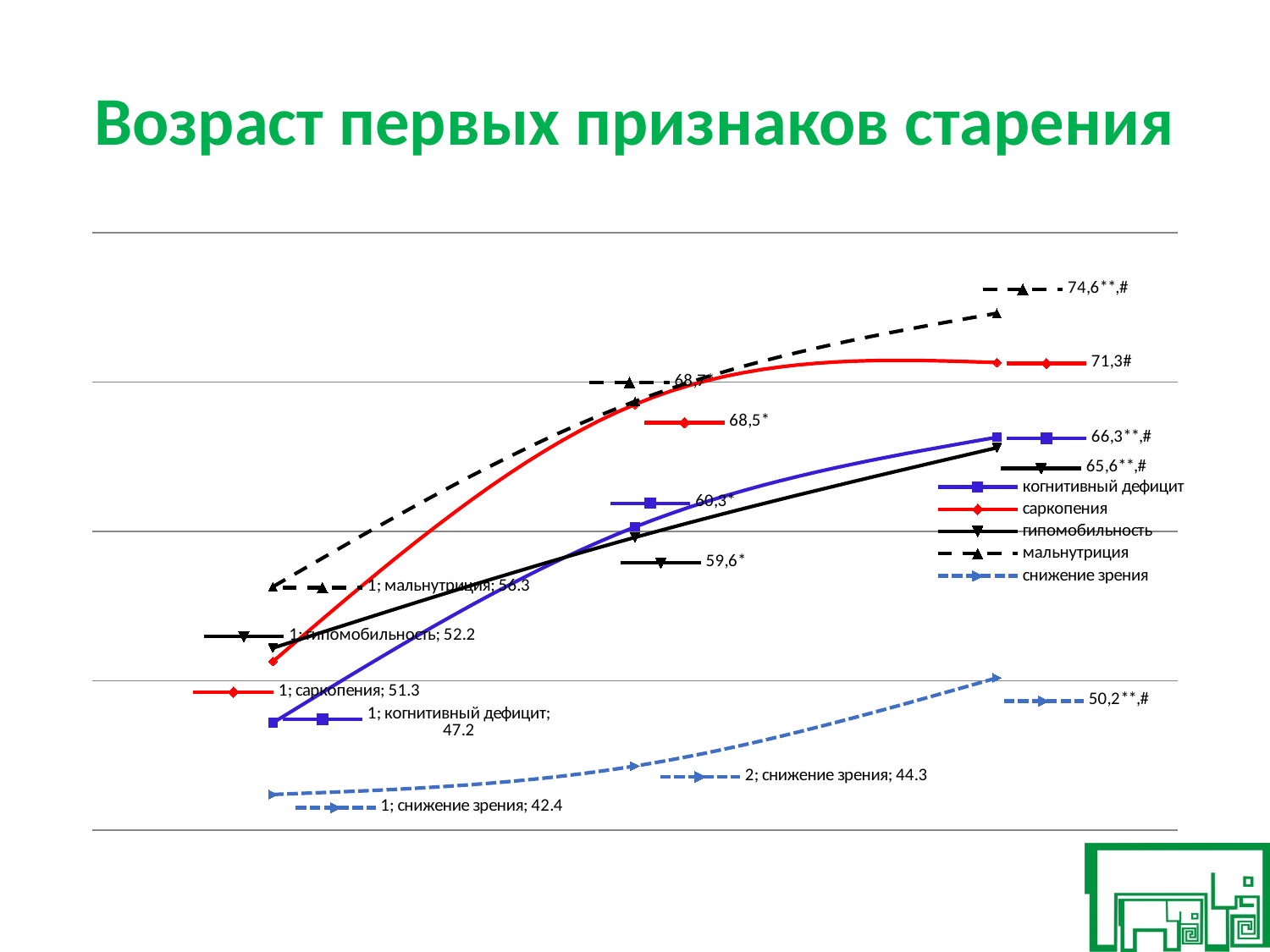
What is the value labelled for саркопения at point 1? 51.3 Which is larger at point 1: the value for мальнутриция or the value for гипомобильность? мальнутриция What is the title of the chart? Возраст первых признаков старения Does the саркопения series rise or fall from point 1 to point 3? rise What is the value labelled for мальнутриция at the last (third) point? 74,6**,# What is the value labelled for когнитивный дефицит at point 1? 47.2 What kind of chart is shown on the slide? line chart How many series does the legend list? 5 What is the value labelled for снижение зрения at point 2? 44.3 Which series has the lowest value at point 1? снижение зрения What is the value labelled for гипомобильность at point 2? 59,6* Which series has the highest value at the last (third) point? мальнутриция